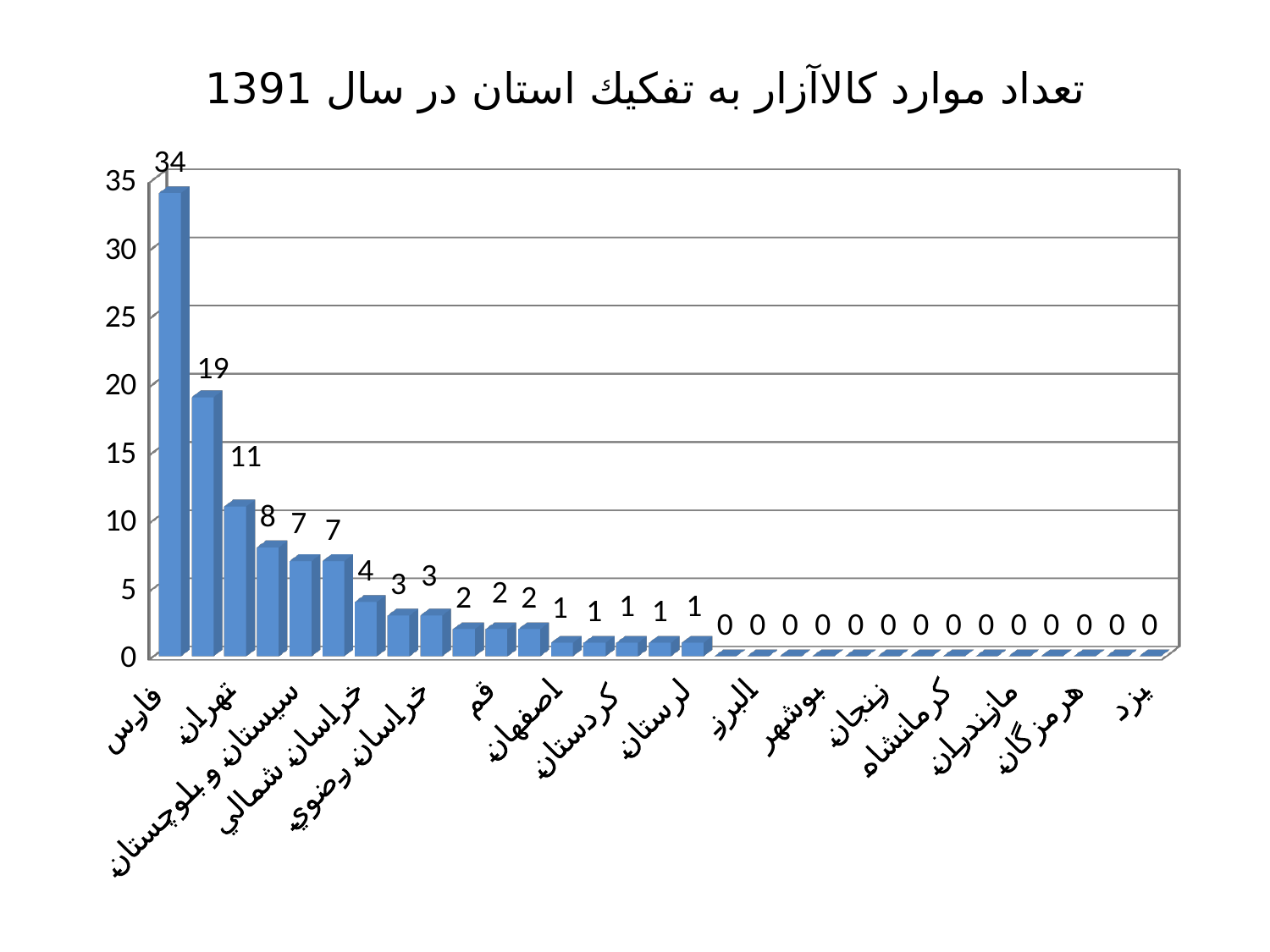
What is the title of the chart? تعداد موارد كالاآزار به تفكيك استان در سال 1391 What is the third highest value shown in the chart? 11 How many data series are plotted in the chart? 1 What is the second highest value shown in the chart? 19 Is the value for فارس greater or less than 30? greater What is the difference between the highest bar (34) and the second highest bar (19)? 15 What is the highest value shown in the chart? 34 What is the lowest value shown in the chart? 0 What is the value for فارس? 34 Which province has the highest number of cases? فارس Do the values rise or fall moving from left to right along the x axis? fall What kind of chart is shown on the slide? bar chart